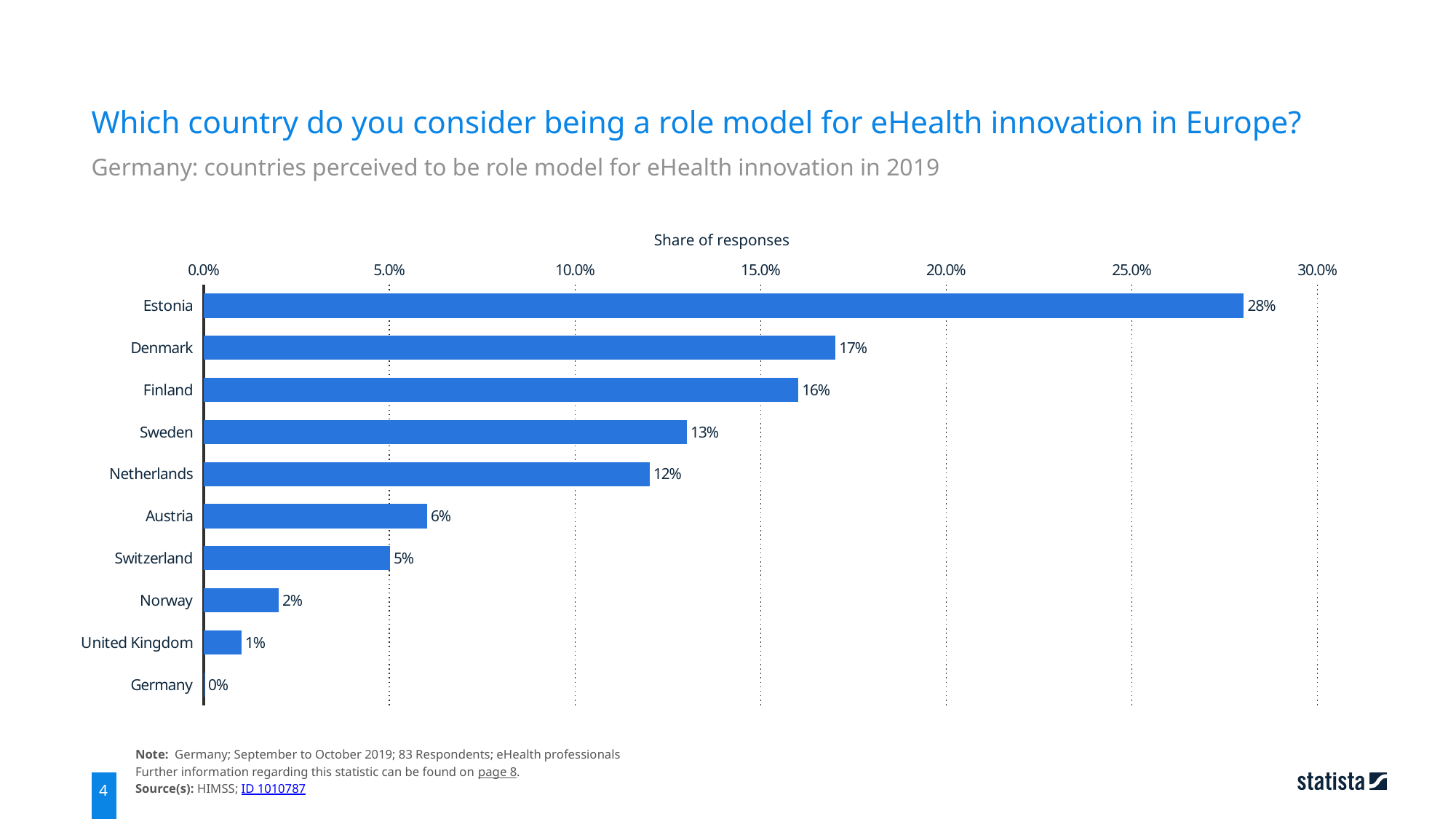
What kind of chart is shown on the slide? Bar chart What is the share of responses for the Netherlands? 12% Which country has the lowest share of responses? Germany How many countries are shown in the chart? 10 What is the difference in share of responses between Estonia and Sweden? 15% Which has a larger share of responses, Austria or Norway? Austria What is the label of the value axis of the chart? Share of responses Is the value for Denmark greater or less than 15.0%? greater What is the share of responses for Switzerland? 5% What share of responses named Estonia as a role model for eHealth innovation? 28% What is the difference in share of responses between Denmark and Finland? 1% Which country has the highest share of responses? Estonia